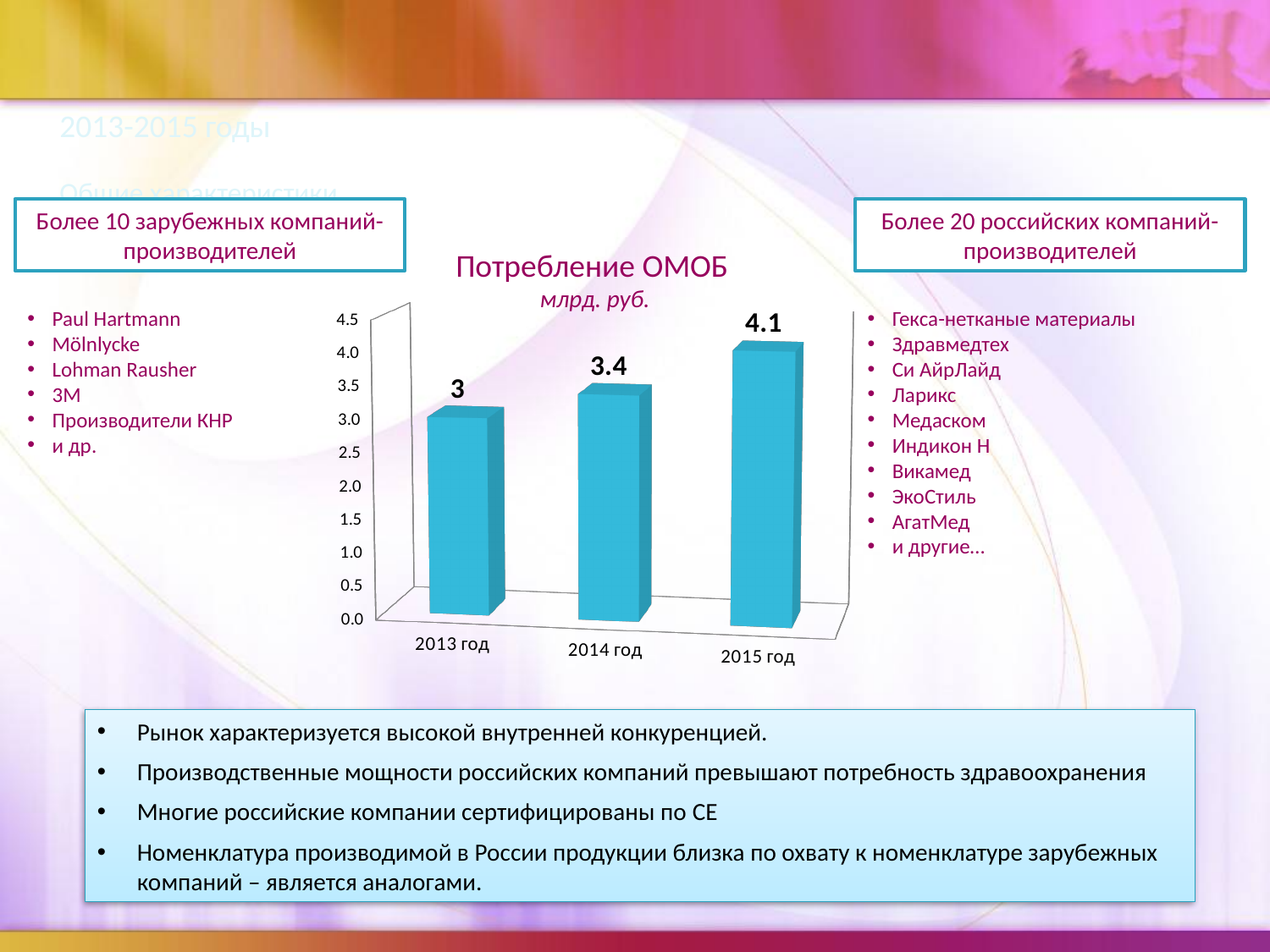
Do the values rise or fall from 2013 год to 2015 год? rise What is the value for 2013 год in the chart? 3 What is the difference between the values for 2015 год and 2013 год? 1.1 Is the value for 2015 год greater or less than 4.0? greater Which is larger, the value for 2014 год or the value for 2015 год? 2015 год Which year has the highest value in the chart? 2015 год What kind of chart is shown on the slide? bar chart What is the difference between the values for 2014 год and 2013 год? 0.4 Which year has the lowest value in the chart? 2013 год What is the value for 2014 год in the chart? 3.4 What is the value for 2015 год in the chart? 4.1 How many years are shown in the chart? 3